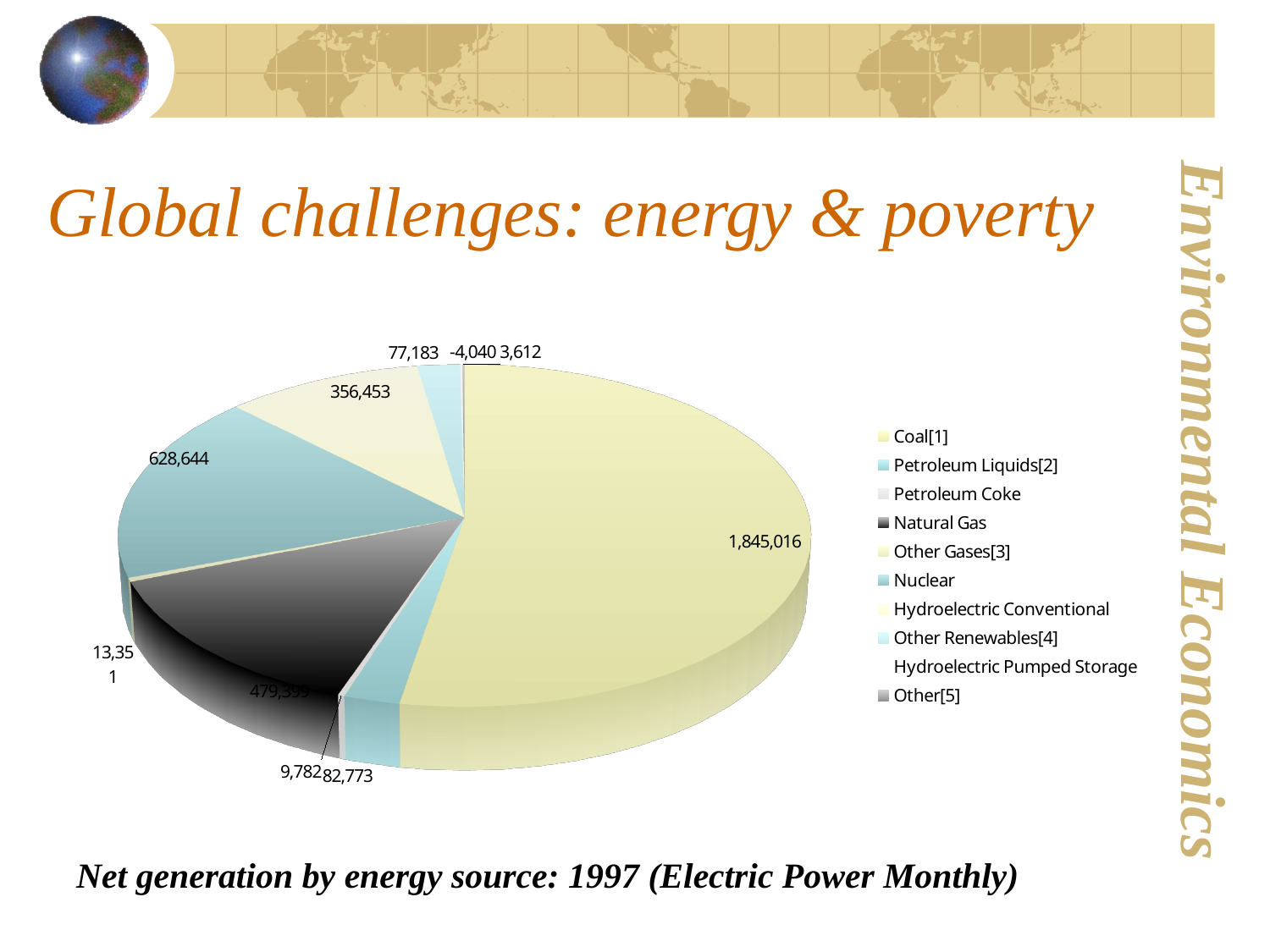
Which energy source has the largest slice of the pie chart? Coal[1] What is the net generation value shown for Other Renewables[4]? 77,183 What is the net generation value shown for Hydroelectric Pumped Storage? -4,040 What is the net generation value shown for Nuclear? 628,644 How many energy sources does the legend of the pie chart list? 10 Which is larger, the value for Nuclear or the value for Hydroelectric Conventional? Nuclear Which energy source has the lowest (negative) value in the pie chart? Hydroelectric Pumped Storage What is the net generation value shown for Petroleum Liquids[2]? 82,773 What is the difference between the values for Nuclear and Hydroelectric Conventional? 272,191 What is the net generation value shown for Hydroelectric Conventional? 356,453 What is the net generation value shown for Coal[1]? 1,845,016 What kind of chart is shown on the slide? pie chart